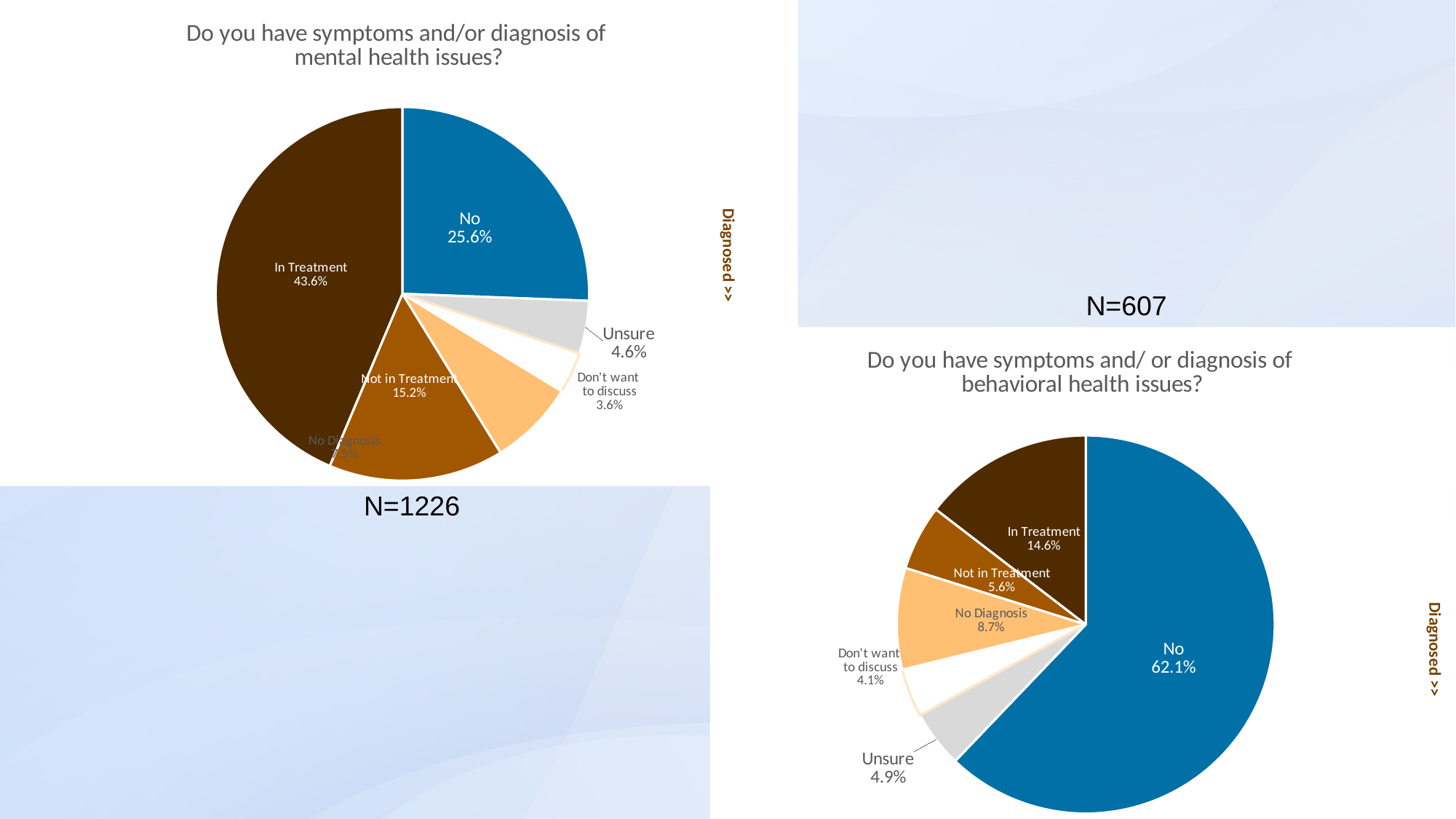
What is the sample size (N) shown for the chart titled "Do you have symptoms and/ or diagnosis of behavioral health issues?"? N=607 In the chart titled "Do you have symptoms and/ or diagnosis of behavioral health issues?", what percentage is "No Diagnosis"? 8.7% How many slices does the chart titled "Do you have symptoms and/ or diagnosis of behavioral health issues?" have? 6 In the chart titled "Do you have symptoms and/or diagnosis of mental health issues?", what percentage is "In Treatment"? 43.6% What type of chart is used for "Do you have symptoms and/ or diagnosis of behavioral health issues?"? Pie chart In the chart titled "Do you have symptoms and/or diagnosis of mental health issues?", what is the difference between the "In Treatment" and "Not in Treatment" percentages? 28.4% In the chart titled "Do you have symptoms and/or diagnosis of mental health issues?", which is larger, "Unsure" or "Don't want to discuss"? Unsure In the chart titled "Do you have symptoms and/ or diagnosis of behavioral health issues?", what is the difference between "In Treatment" and "Not in Treatment"? 9.0% In the chart titled "Do you have symptoms and/ or diagnosis of behavioral health issues?", what percentage answered "No"? 62.1% In the chart titled "Do you have symptoms and/or diagnosis of mental health issues?", which category has the largest slice? In Treatment In the chart titled "Do you have symptoms and/or diagnosis of mental health issues?", what percentage answered "No"? 25.6% In the chart titled "Do you have symptoms and/ or diagnosis of behavioral health issues?", which category has the smallest slice? Don't want to discuss